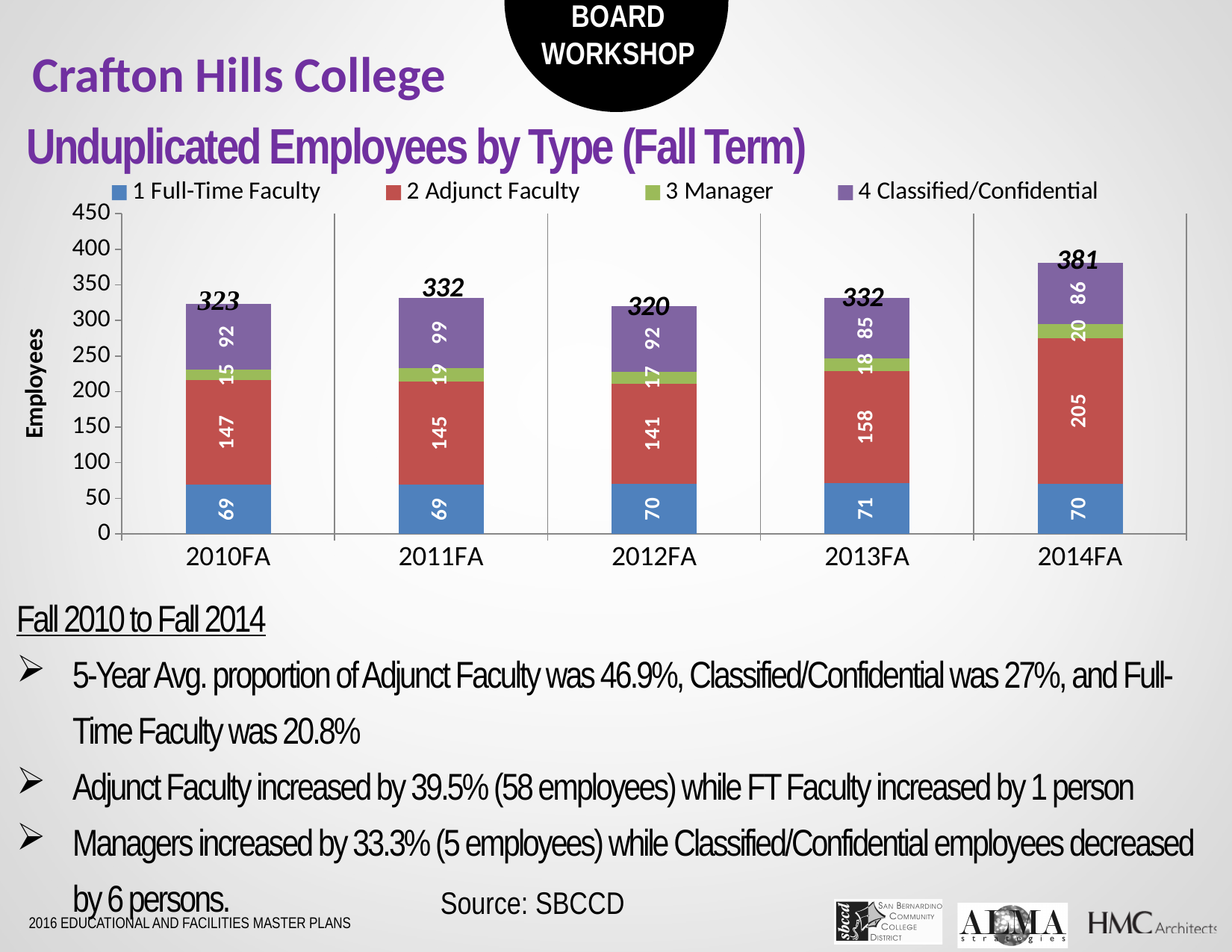
What is the value for 4 Classified/Confidential in 2011FA? 99 What kind of chart is shown on the slide? Stacked bar chart Which is larger, the 4 Classified/Confidential value in 2011FA or in 2014FA? 2011FA Which fall term has the highest total number of employees? 2014FA What is the difference between the 2 Adjunct Faculty values in 2014FA and 2010FA? 58 What is the value for 3 Manager in 2012FA? 17 Which fall term has the lowest total number of employees? 2012FA How many fall terms are shown on the x axis? 5 What is the total of the stacked bar for 2014FA? 381 How many series does the legend list? 4 What is the value for 2 Adjunct Faculty in 2014FA? 205 What is the value for 1 Full-Time Faculty in 2013FA? 71